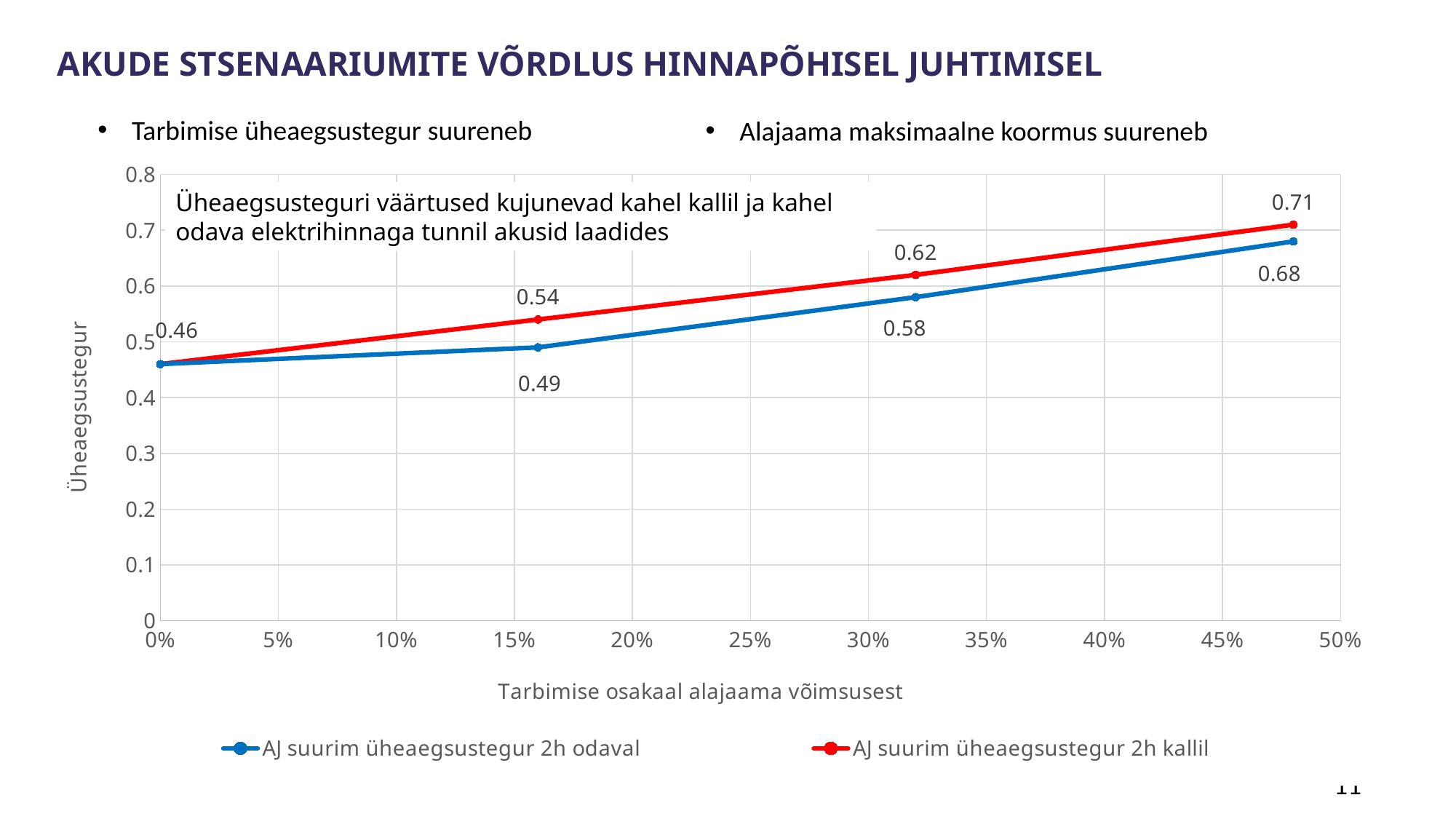
Do the values of the 'AJ suurim üheaegsustegur 2h kallil' series rise or fall as the x-axis value increases? rise How many series does the chart legend list? 2 What is the difference between the two series at the rightmost data point (0.71 vs 0.68)? 0.03 What is the value of the 'AJ suurim üheaegsustegur 2h kallil' series at its third data point? 0.62 What is the title of the chart's y axis? Üheaegsustegur What is the value of both series at 0% on the x axis? 0.46 What is the value of the 'AJ suurim üheaegsustegur 2h kallil' series at its rightmost data point? 0.71 Which series has the higher value at the rightmost data point? AJ suurim üheaegsustegur 2h kallil How many data points does each series in the chart have? 4 What is the value of the 'AJ suurim üheaegsustegur 2h odaval' series at its rightmost data point? 0.68 What kind of chart is shown on the slide? line chart What is the value of the 'AJ suurim üheaegsustegur 2h odaval' series at its second data point? 0.49